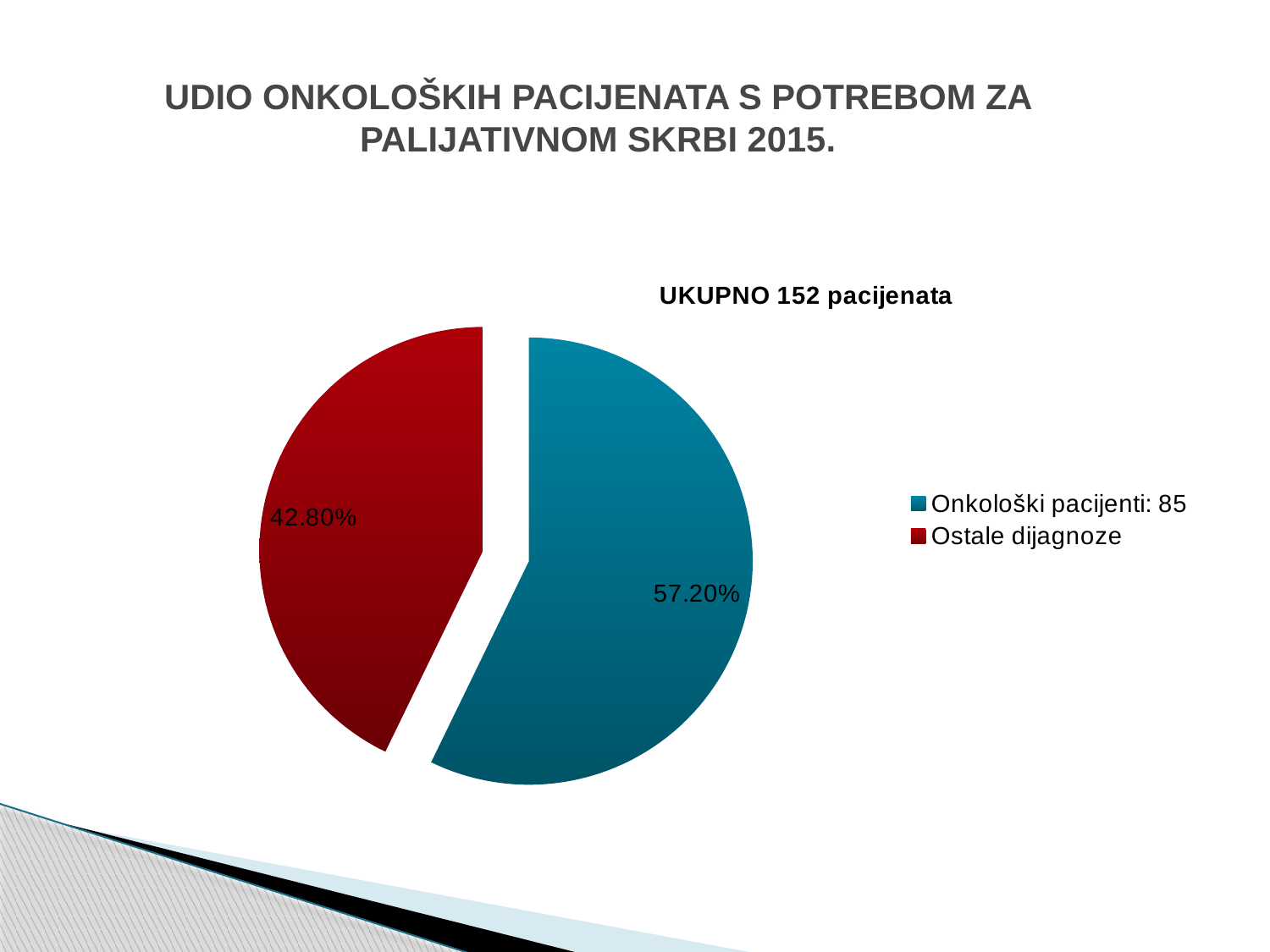
What is the difference in percentage points between the 'Onkološki pacijenti: 85' slice and the 'Ostale dijagnoze' slice? 14.40% What kind of chart is shown on the slide? pie chart Which slice of the pie is the largest? Onkološki pacijenti: 85 How many slices does the pie chart have? 2 What share of the pie does the 'Onkološki pacijenti: 85' slice represent? 57.20% What share of the pie does the 'Ostale dijagnoze' slice represent? 42.80% What is the chart's title? UKUPNO 152 pacijenata How many entries does the legend list? 2 Which slice of the pie is the smallest? Ostale dijagnoze Which is larger, the 'Onkološki pacijenti: 85' slice or the 'Ostale dijagnoze' slice? Onkološki pacijenti: 85 What colour is the 'Ostale dijagnoze' slice? red